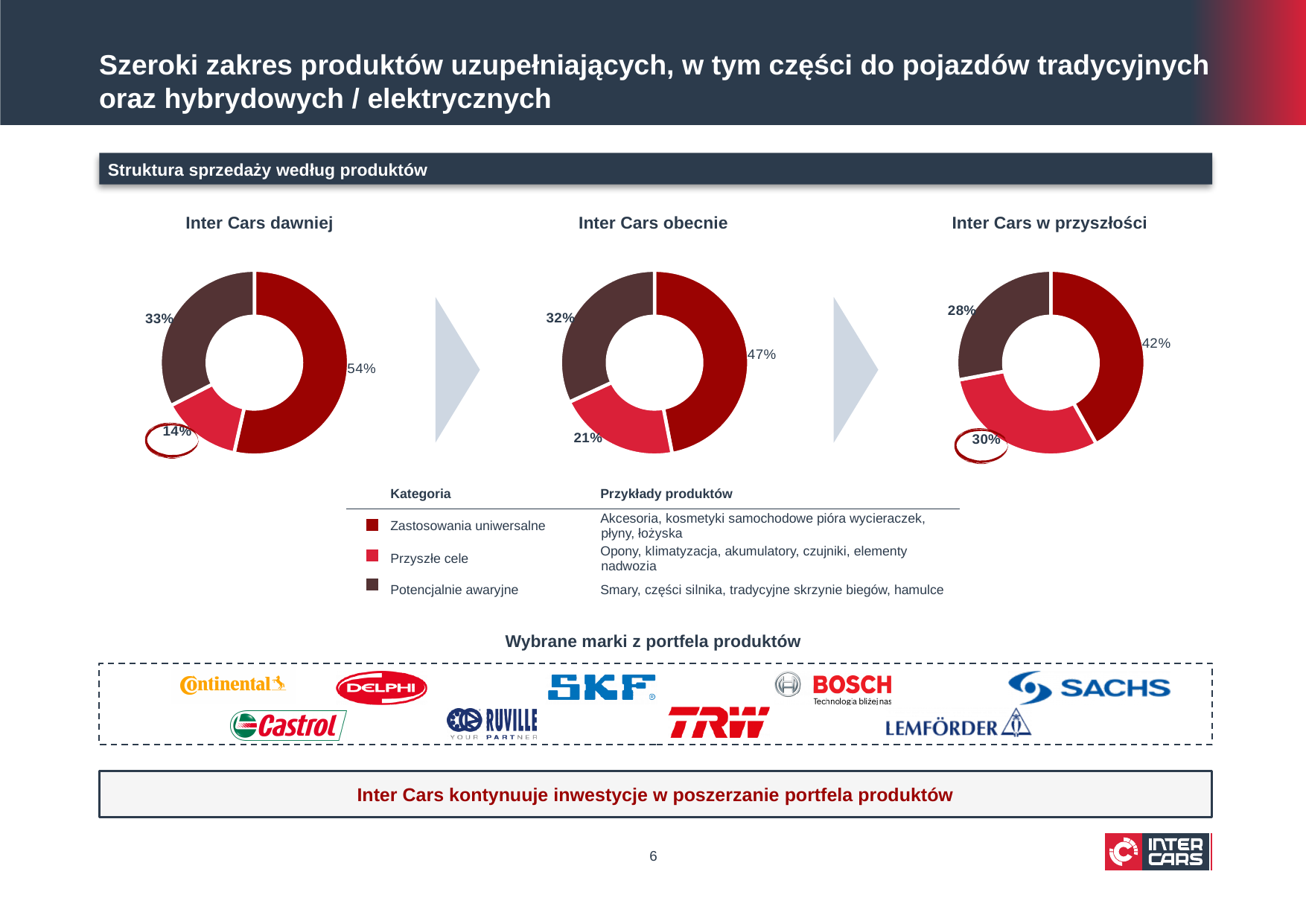
What type of chart is used to show the sales structure by product? Donut (pie) chart In the 'Inter Cars obecnie' chart, which category has the largest share? Zastosowania uniwersalne In the 'Inter Cars dawniej' chart, what share is shown for Zastosowania uniwersalne (dark red slice)? 54% How many categories does each donut chart show? 3 In the 'Inter Cars w przyszłości' chart, what share is shown for Przyszłe cele (bright red slice)? 30% In the 'Inter Cars obecnie' chart, what share is shown for Potencjalnie awaryjne (dark brown slice)? 32% In the 'Inter Cars dawniej' chart, what share is shown for Przyszłe cele (bright red slice)? 14% Which is larger in the 'Inter Cars w przyszłości' chart: the Przyszłe cele share or the Potencjalnie awaryjne share? Przyszłe cele In the 'Inter Cars w przyszłości' chart, what share is shown for Zastosowania uniwersalne (dark red slice)? 42% In the 'Inter Cars dawniej' chart, which category has the smallest share? Przyszłe cele What is the difference between the Zastosowania uniwersalne share in 'Inter Cars dawniej' (54%) and in 'Inter Cars w przyszłości' (42%)? 12 percentage points How does the Przyszłe cele share change across the three charts from 'Inter Cars dawniej' to 'Inter Cars w przyszłości'? It rises (14%, 21%, 30%)